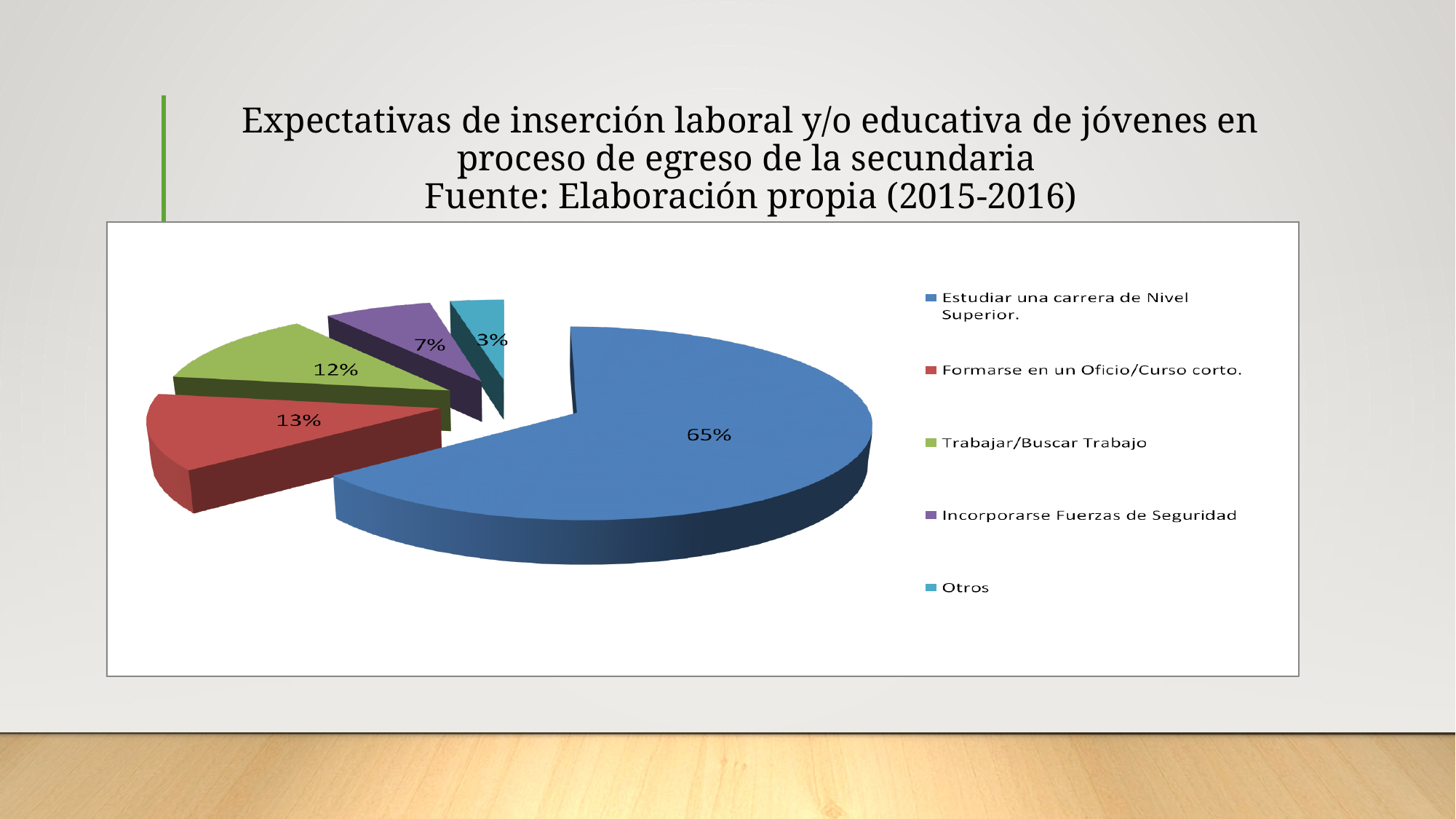
What type of chart is shown on the slide? Pie chart What percentage is shown for "Trabajar/Buscar Trabajo"? 12% What percentage is shown for "Formarse en un Oficio/Curso corto."? 13% How many categories does the legend list? 5 What is the difference in percentage points between "Estudiar una carrera de Nivel Superior." and "Formarse en un Oficio/Curso corto."? 52 Which category has the smallest share of the pie? Otros What percentage of the pie corresponds to "Estudiar una carrera de Nivel Superior."? 65% What percentage is shown for "Otros"? 3% What percentage is shown for "Incorporarse Fuerzas de Seguridad"? 7% What colour is the slice for "Trabajar/Buscar Trabajo"? Green Which is larger: the share for "Incorporarse Fuerzas de Seguridad" or the share for "Otros"? Incorporarse Fuerzas de Seguridad Which category has the largest share of the pie? Estudiar una carrera de Nivel Superior.